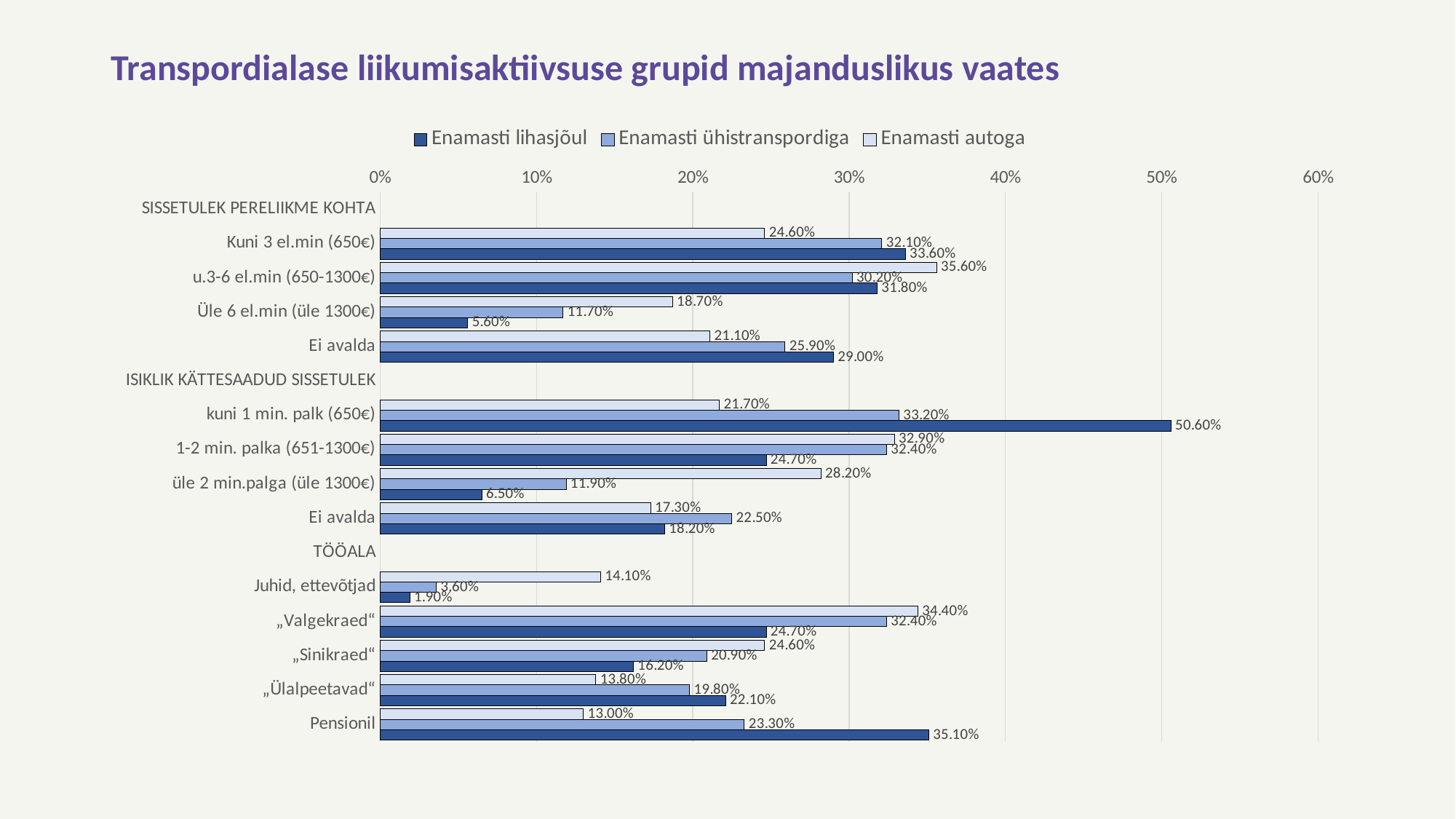
For "„Sinikraed“", which is larger: the "Enamasti autoga" value or the "Enamasti lihasjõul" value? Enamasti autoga Which category has the lowest value for the "Enamasti ühistranspordiga" series? Juhid, ettevõtjad How many series does the legend list? 3 What is the value for "Enamasti lihasjõul" in the category "kuni 1 min. palk (650€)"? 50.60% What is the difference between the "Enamasti lihasjõul" and "Enamasti autoga" values for "Pensionil"? 22.10% What type of chart is shown on the slide? bar chart What is the value for "Enamasti autoga" in the category "Juhid, ettevõtjad"? 14.10% Is the "Enamasti autoga" value for "u.3-6 el.min (650-1300€)" greater or less than 30%? greater Which category has the highest value for the "Enamasti lihasjõul" series? kuni 1 min. palk (650€) What is the value for "Enamasti ühistranspordiga" in the category "Pensionil"? 23.30% What is the value for "Enamasti lihasjõul" in the category "Üle 6 el.min (üle 1300€)"? 5.60% What is the title of the chart? Transpordialase liikumisaktiivsuse grupid majanduslikus vaates